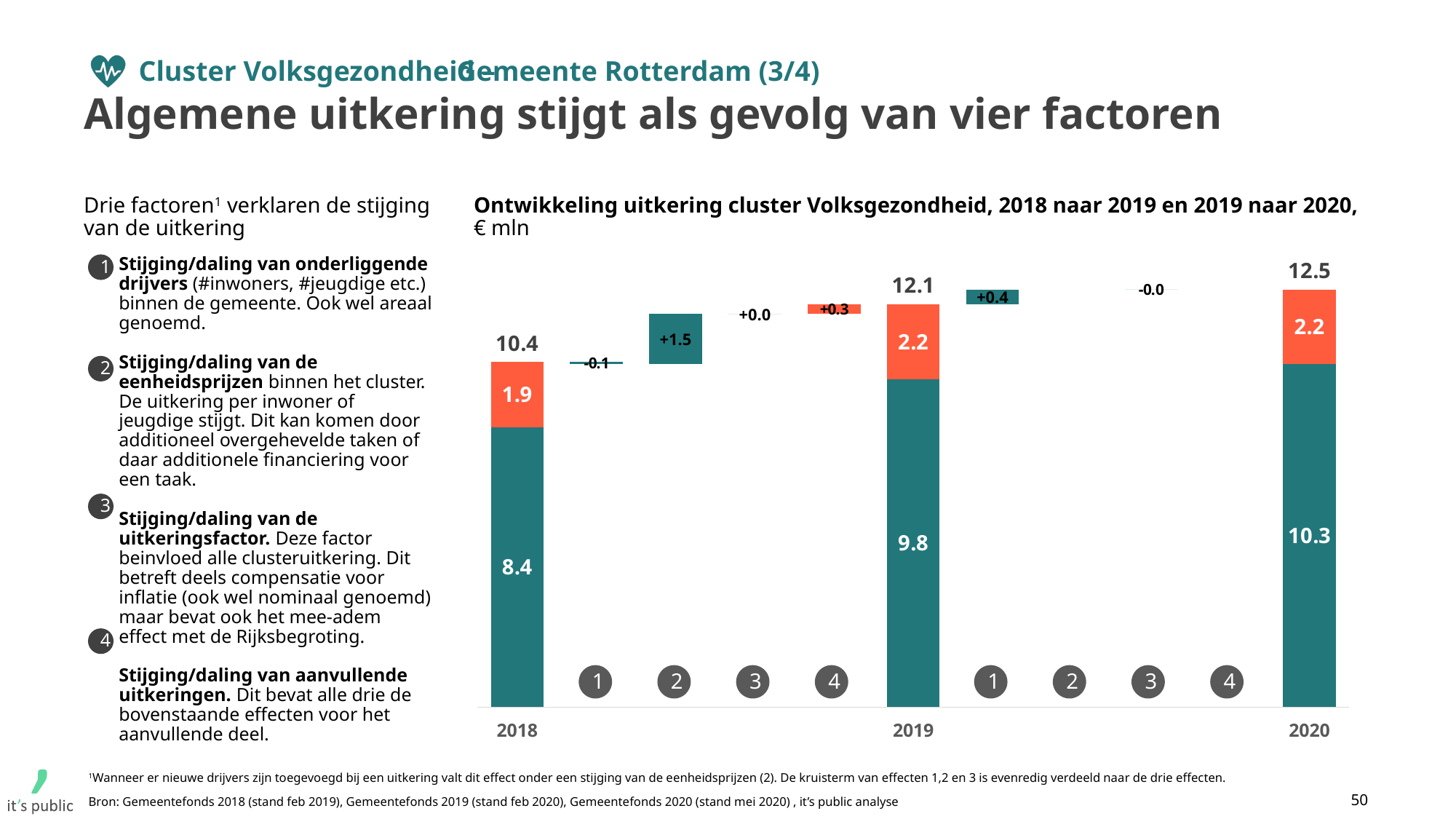
What is the value of the orange (upper) segment of the 2020 bar? 2.2 What is the effect of factor 1 between 2018 and 2019? -0.1 By how much does the 2020 total exceed the 2018 total? 2.1 What is the effect of factor 2 between 2018 and 2019? +1.5 Which year has the highest total uitkering? 2020 What is the value of the teal (lower) segment of the 2018 bar? 8.4 What is the total value shown above the 2018 bar? 10.4 What is the effect of factor 1 between 2019 and 2020? +0.4 What is the total value shown above the 2020 bar? 12.5 What is the total value shown above the 2019 bar? 12.1 What is the value of the teal (lower) segment of the 2019 bar? 9.8 In what unit are the values in the chart expressed? € mln